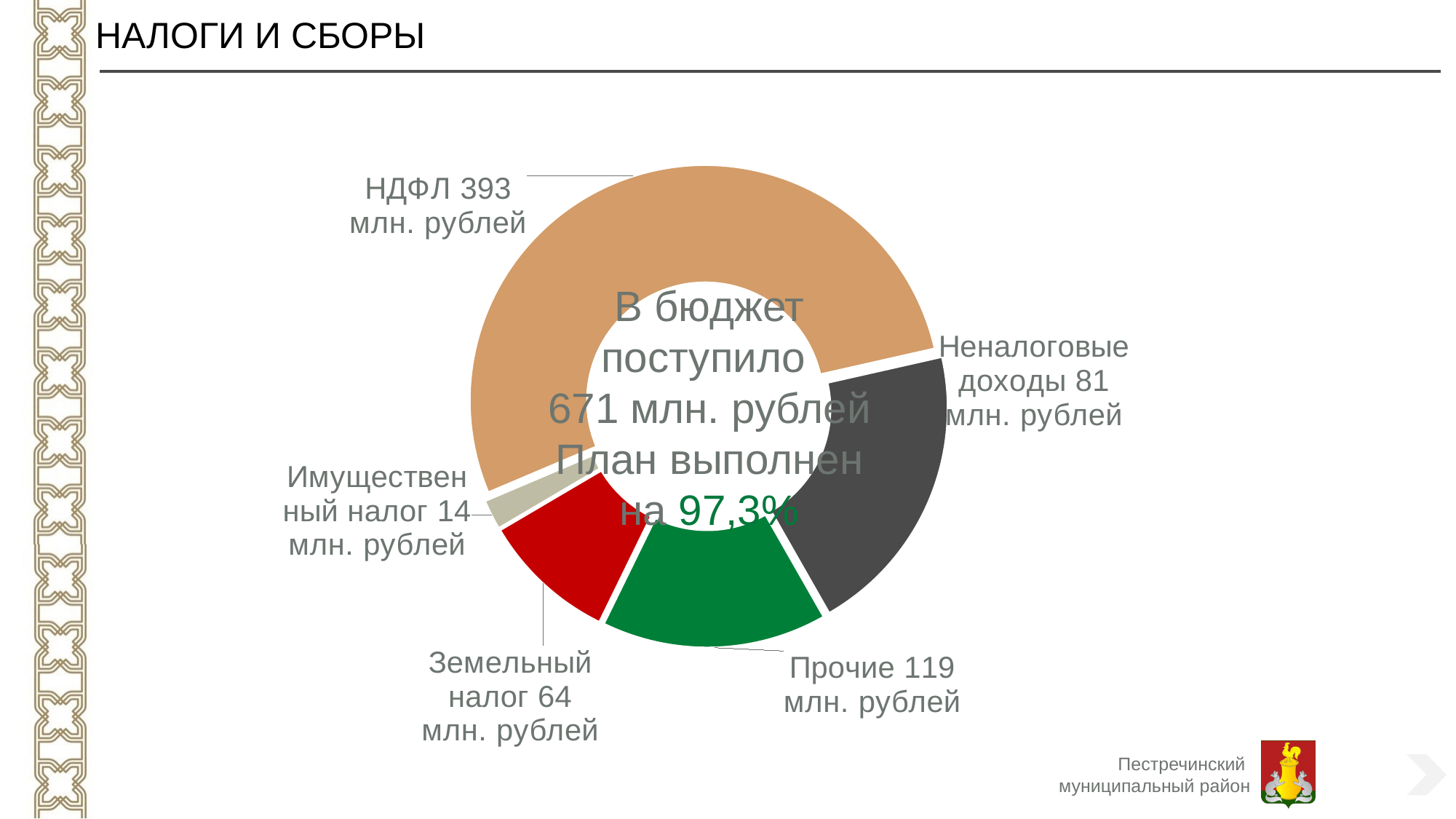
What is the difference between Земельный налог and Имущественный налог? 50 млн. рублей Which category has the largest value? НДФЛ What is the difference between НДФЛ and Прочие? 274 млн. рублей What value is shown for НДФЛ? 393 млн. рублей What value is shown for Имущественный налог? 14 млн. рублей What total amount received into the budget is stated in the centre of the chart? 671 млн. рублей Which is larger, Прочие or Неналоговые доходы? Прочие What kind of chart is shown on the slide? doughnut chart What value is shown for Неналоговые доходы? 81 млн. рублей What value is shown for Земельный налог? 64 млн. рублей Which category has the smallest value? Имущественный налог How many categories does the chart show? 5